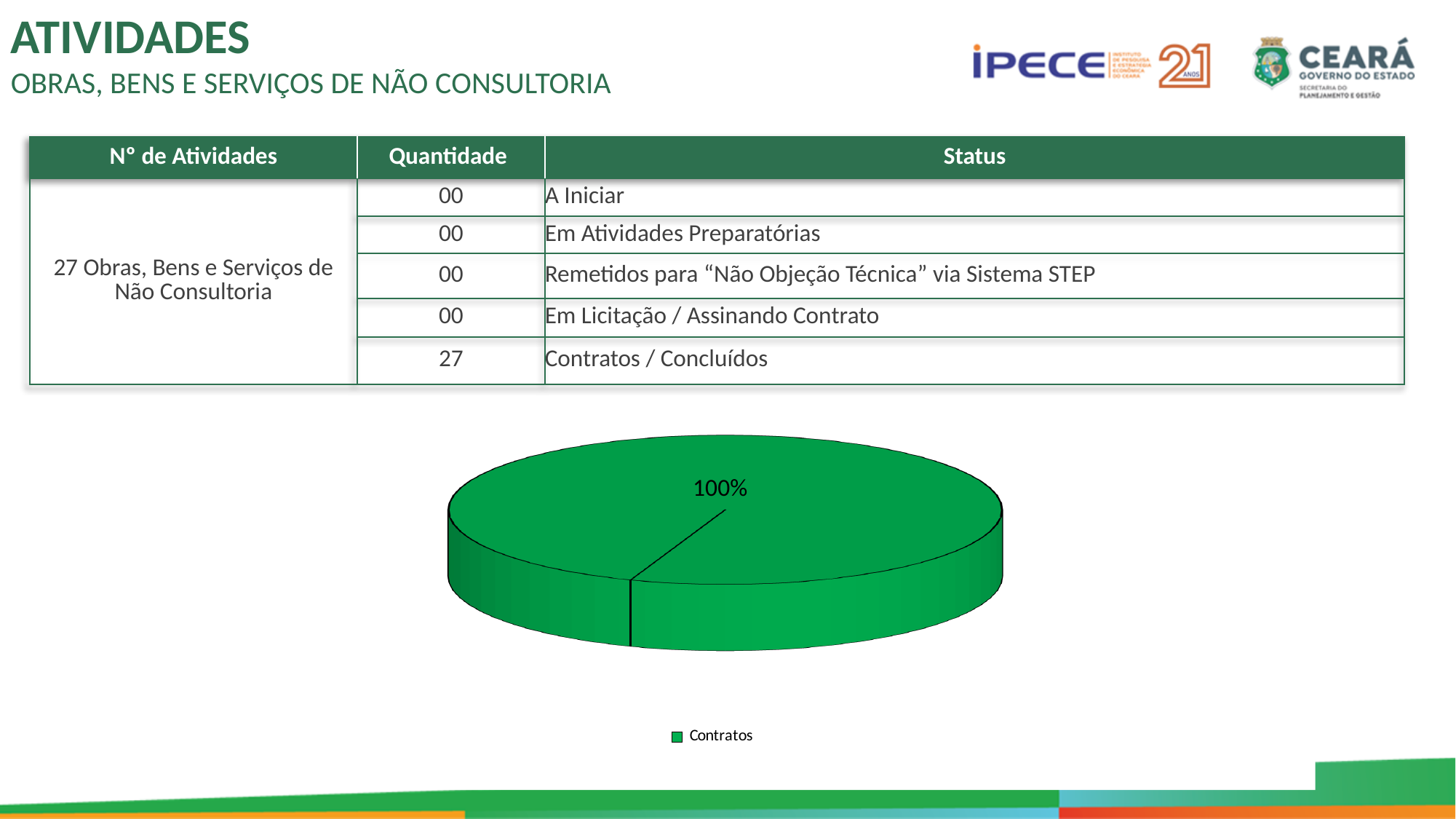
How many entries does the chart legend list? 1 What share of the pie does the Contratos slice represent? 100% What kind of chart is shown on the slide? pie chart What colour is the Contratos slice in the pie chart? green How many slices does the pie chart have? 1 What percentage is printed as the data label on the pie chart? 100% What is the label of the only legend entry in the pie chart? Contratos